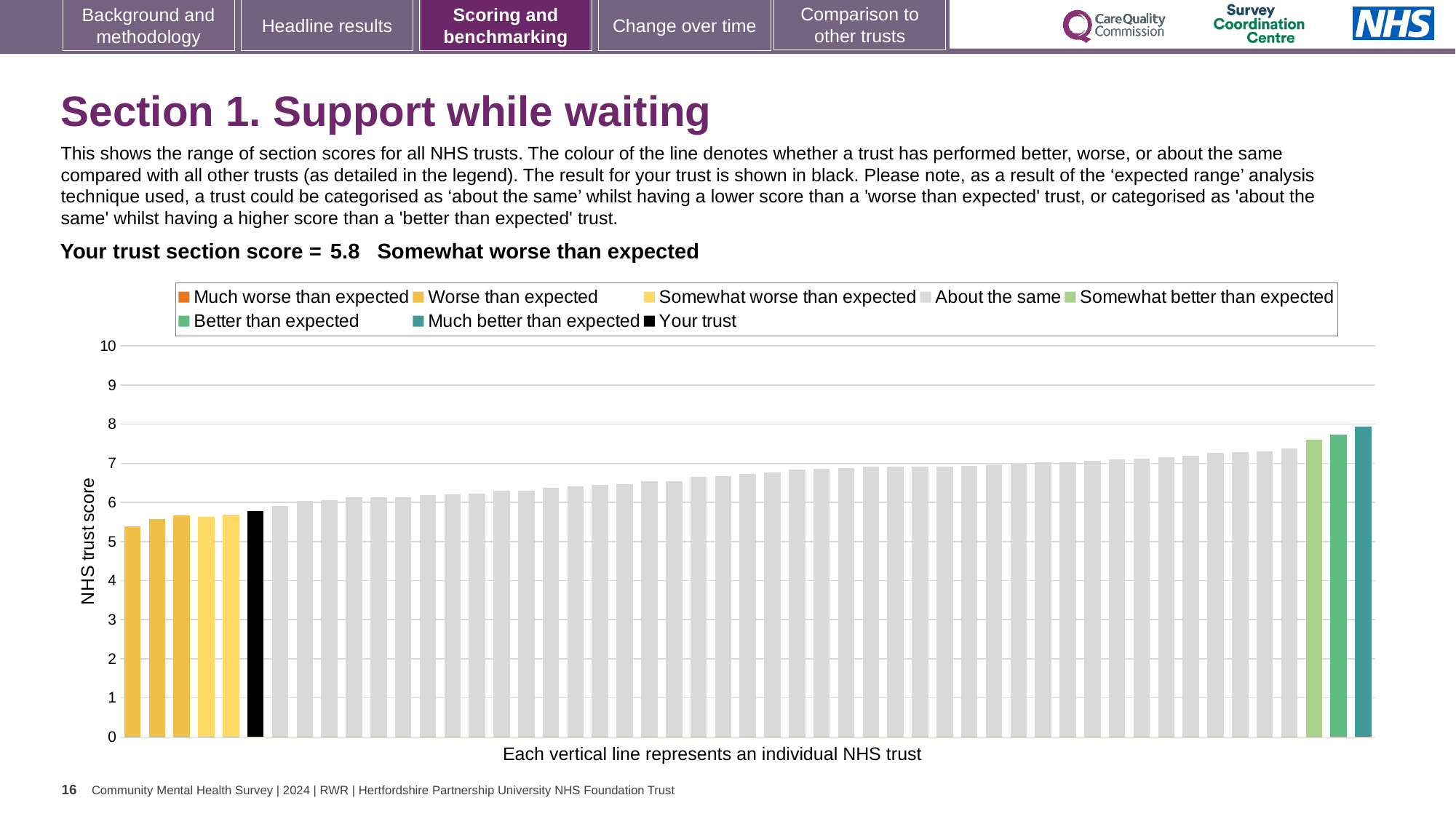
How many entries does the chart legend list? 8 What is the section score for your trust shown on the slide? 5.8 What kind of chart is shown on the slide? bar chart Which legend category does the highest-scoring trust (rightmost bar) belong to? Much better than expected Do the bar values rise or fall from left to right along the x axis? rise What colour is used for the bar representing your trust? black Is the value for the leftmost bar greater or less than 6? less Is the value for your trust (the black bar) greater or less than 6? less Which is larger: the value for your trust (black bar) or the value for the rightmost bar? the rightmost bar What is the label on the vertical axis? NHS trust score How many bars are coloured in the green/teal 'better than expected' shades? 3 Is the value for the tallest bar (rightmost trust) greater or less than 7? greater